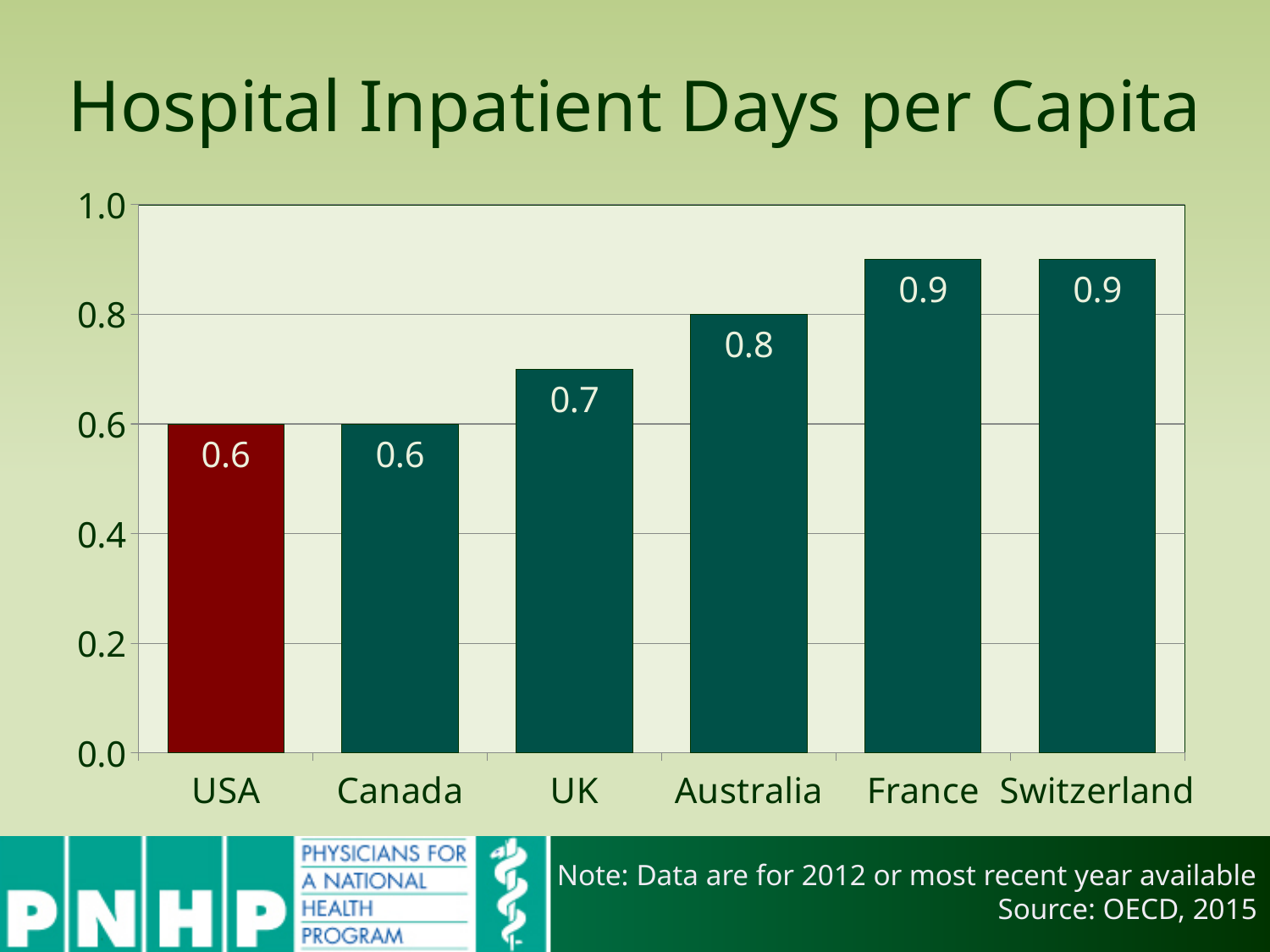
Do the values generally rise or fall from left to right across the countries? Rise Is the value for France greater or less than 0.8? greater What is the value for the UK? 0.7 What is the value for Canada? 0.6 What is the difference between the values for Switzerland and the USA? 0.3 What is the value for Australia? 0.8 What is the difference between the values for Australia and Canada? 0.2 What is the value for France? 0.9 Which country has the highest value, Australia or the UK? Australia Which country's bar is coloured differently from the others? USA How many countries are shown on the chart? 6 What kind of chart is shown on the slide? Bar chart